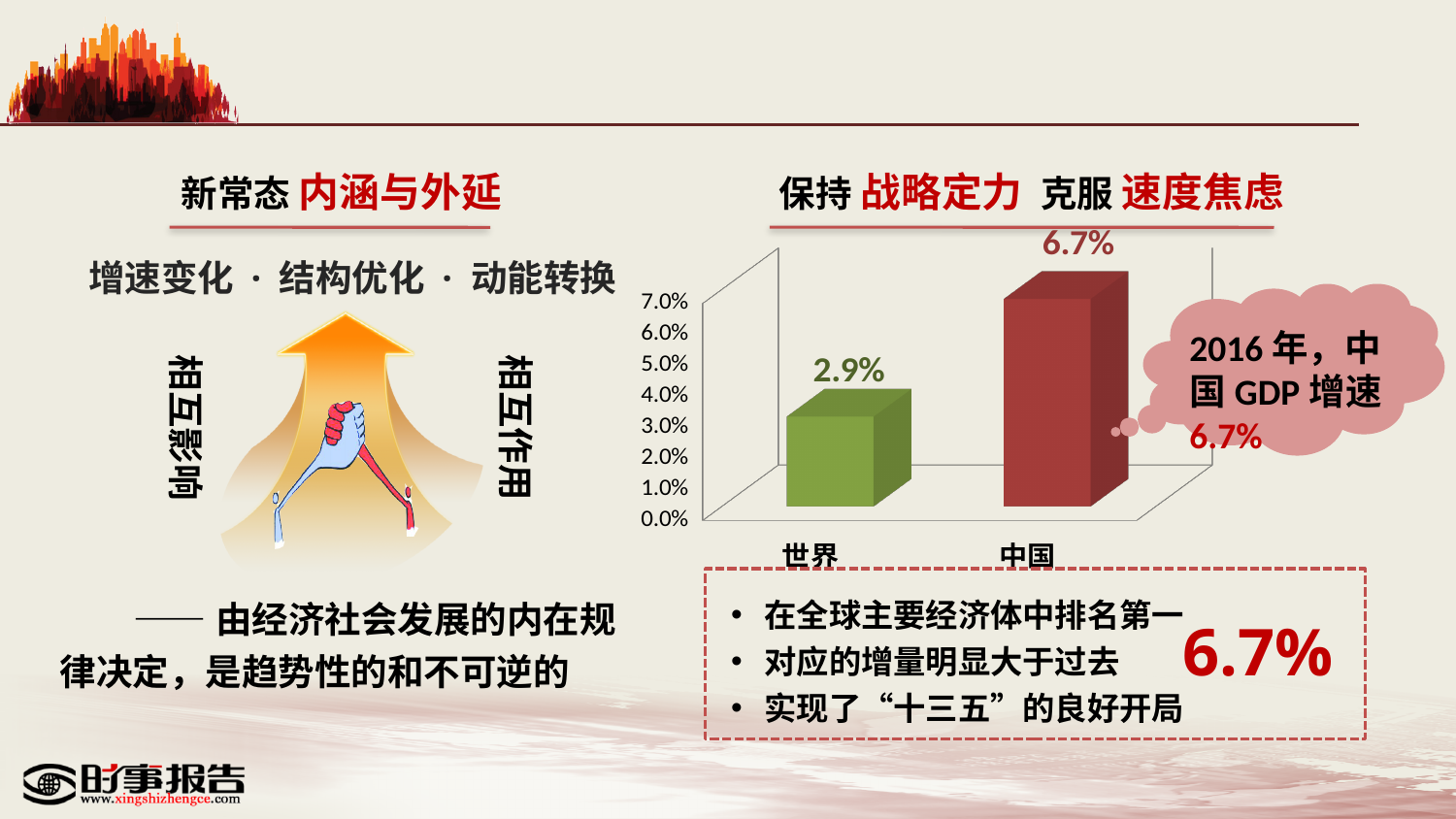
What is the difference between the values for 中国 and 世界 in the bar chart? 3.8% What is the value shown for 中国 in the bar chart? 6.7% What is the value shown for 世界 in the bar chart? 2.9% Which category has the highest value in the bar chart? 中国 What kind of chart is shown on the slide? bar chart Which category has the lowest value in the bar chart? 世界 Is the value for 世界 in the bar chart greater or less than 3.0%? less Which is larger in the bar chart, the value for 世界 or the value for 中国? 中国 Is the value for 中国 in the bar chart greater or less than 6.0%? greater How many categories are shown in the bar chart? 2 What colour is the bar for 中国 in the bar chart? red What is the highest tick value shown on the vertical axis of the bar chart? 7.0%